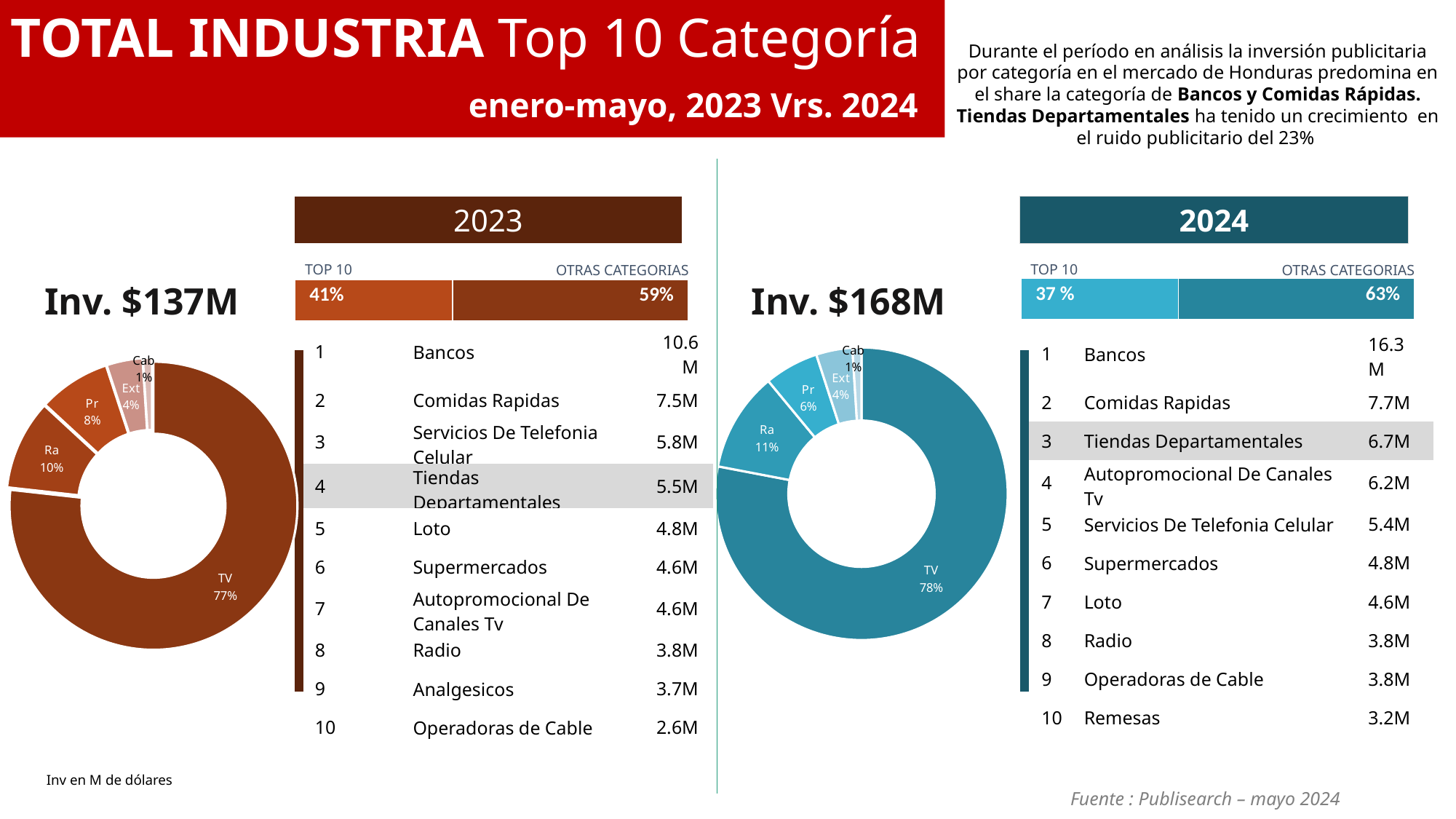
In the 2023 donut chart, what share does Ra have? 10% In the 2024 donut chart, which slice is the smallest? Cab In the 2023 donut chart, which slice is the largest? TV How many slices does the 2023 donut chart have? 5 In the 2024 stacked bar, what share do Otras Categorias have? 63% What is the difference between the Ra share in 2024 and the Ra share in 2023? 1% In the 2024 donut chart, which is larger: Ra or Pr? Ra In the 2024 donut chart, what share does TV have? 78% In the 2023 donut chart, what share does TV have? 77% In the 2023 stacked bar, what share do the Top 10 categories have? 41% What type of chart is used to show the media shares for 2023 and 2024? Donut (pie) chart In the 2024 donut chart, what share does Pr have? 6%